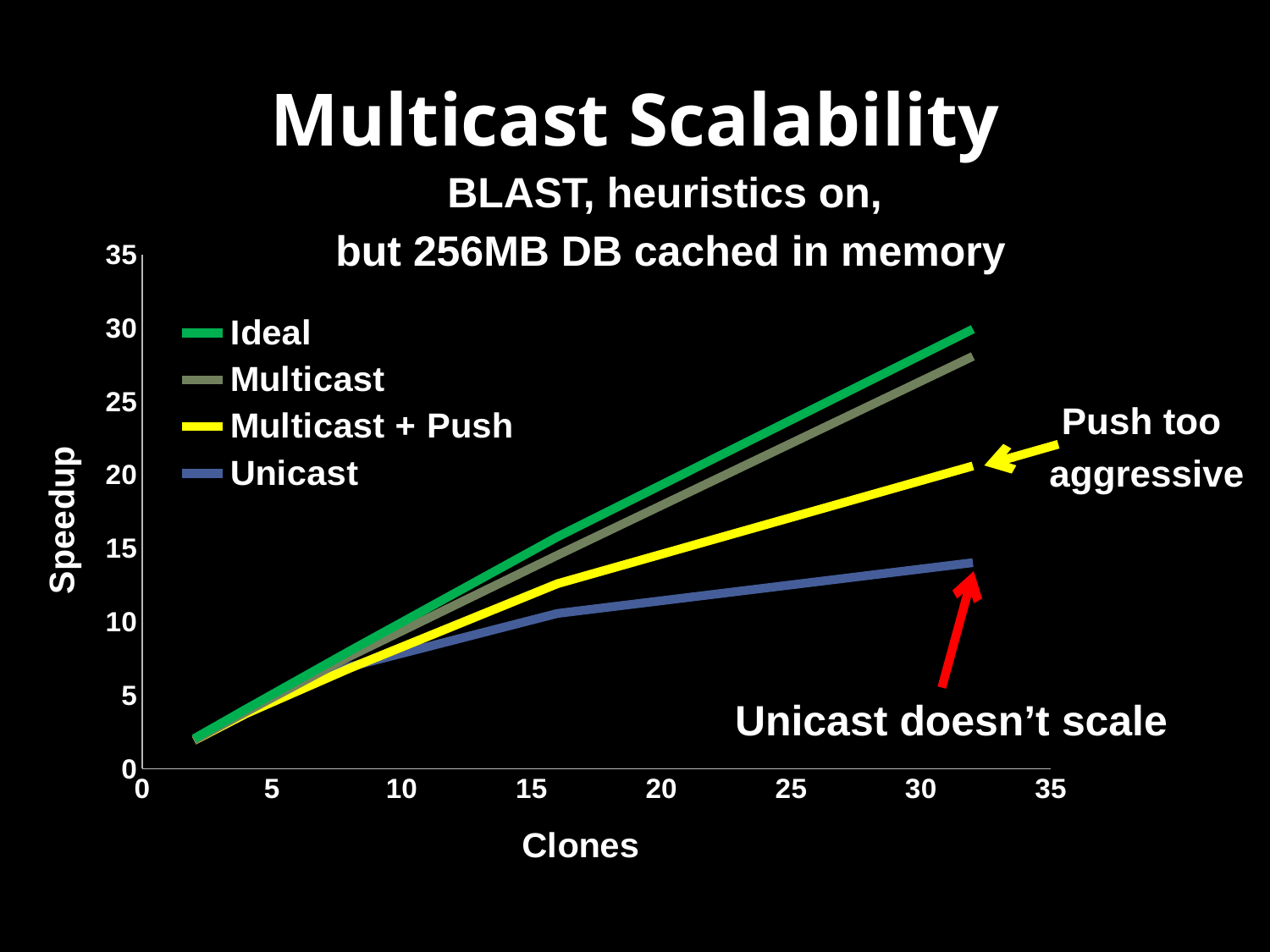
How many series does the legend list? 4 Which series has the highest speedup at 32 clones? Ideal Is the speedup for Ideal at 32 clones greater or less than 25? greater Which series has the lowest speedup at 32 clones? Unicast Does the Unicast speedup rise or fall as the number of clones increases? rise At 32 clones, which is larger: the speedup for Multicast + Push or for Unicast? Multicast + Push What is the label of the y axis? Speedup At 32 clones, which is larger: the speedup for Multicast or for Unicast? Multicast What is the label of the x axis? Clones What kind of chart is shown on the slide? line chart Is the speedup for Unicast at 32 clones greater or less than 10? greater Is the speedup for Multicast + Push at 32 clones greater or less than 15? greater